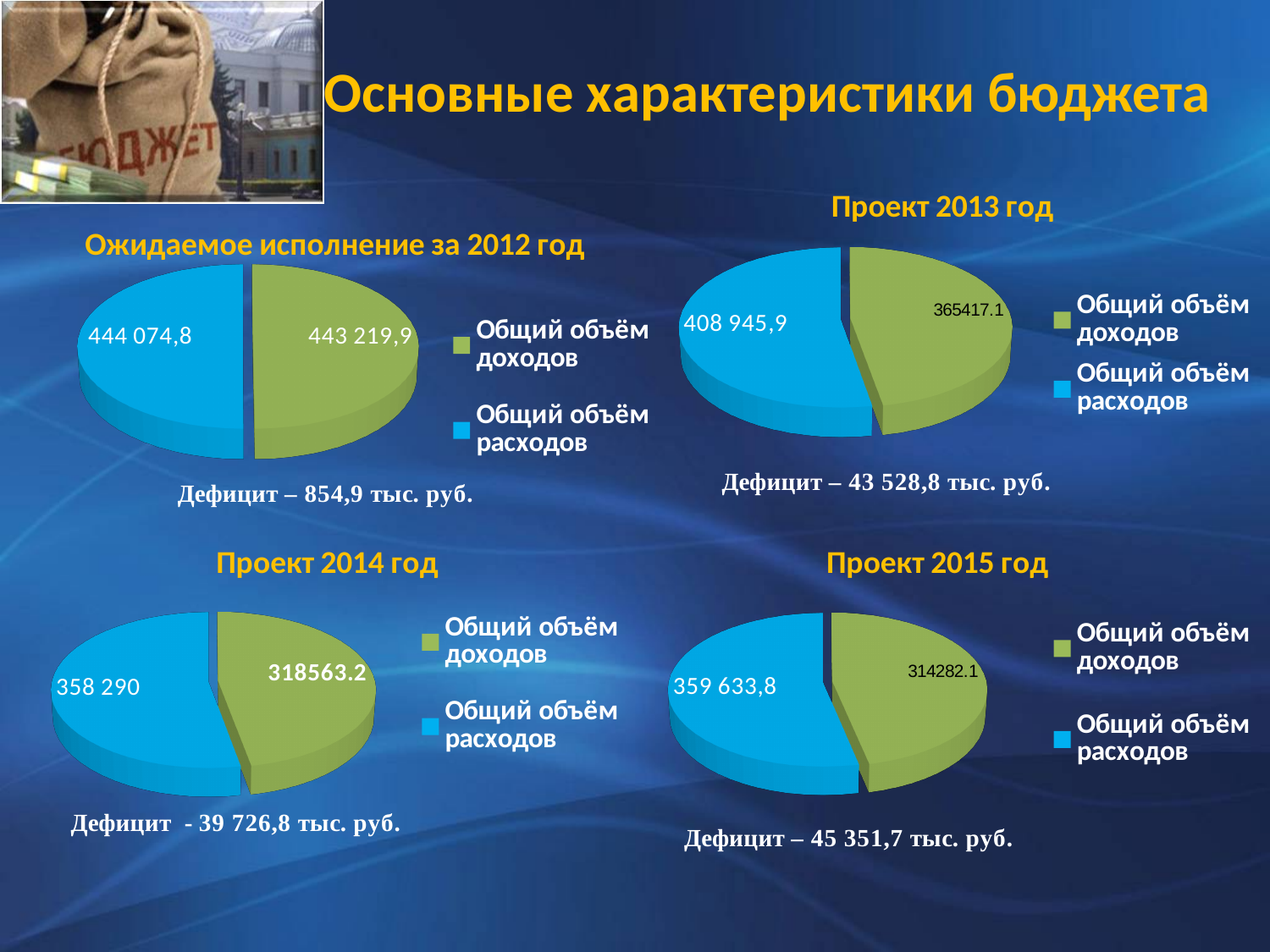
In the chart titled 'Проект 2015 год', which is larger, Общий объём доходов or Общий объём расходов? Общий объём расходов In the chart titled 'Проект 2015 год', what is the value for Общий объём расходов? 359 633,8 How many slices does the chart titled 'Проект 2015 год' have? 2 In the chart titled 'Проект 2014 год', what is the value for Общий объём доходов? 318563.2 What kind of chart is the chart titled 'Проект 2014 год'? Pie chart In the chart titled 'Проект 2013 год', what is the value for Общий объём расходов? 408 945,9 In the chart titled 'Ожидаемое исполнение за 2012 год', what is the value for Общий объём доходов? 443 219,9 In the chart titled 'Ожидаемое исполнение за 2012 год', what is the value for Общий объём расходов? 444 074,8 In the chart titled 'Проект 2014 год', which slice is the largest? Общий объём расходов In the chart titled 'Проект 2013 год', which colour represents Общий объём доходов? Green In the chart titled 'Проект 2013 год', what is the value for Общий объём доходов? 365417.1 In the chart titled 'Проект 2013 год', what is the difference between Общий объём расходов and Общий объём доходов? 43 528,8